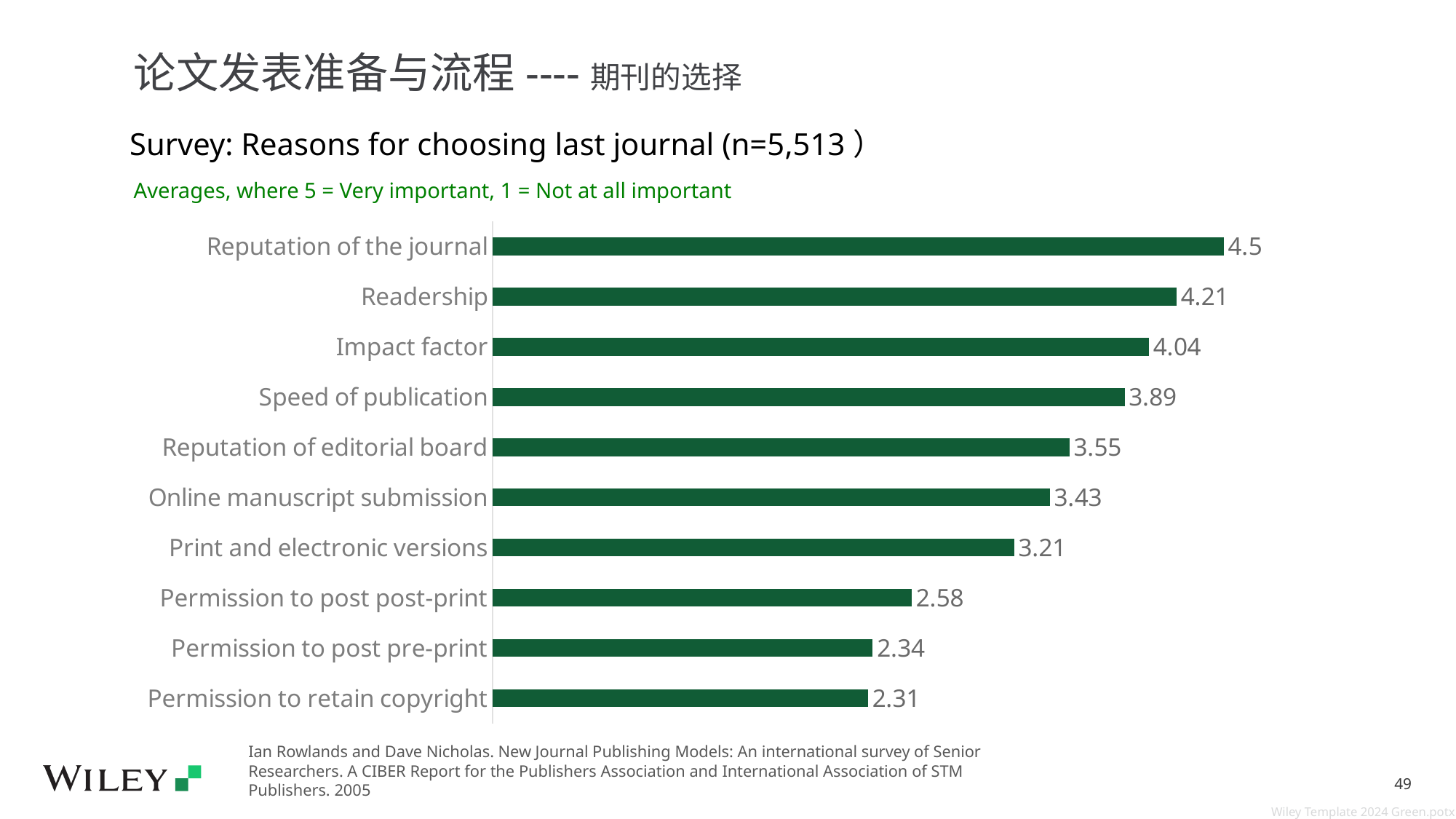
What is the average importance score for Reputation of the journal? 4.5 Which reason has the highest average score? Reputation of the journal What kind of chart is shown on the slide? Bar chart What is the value shown for Speed of publication? 3.89 Which has a higher score, Online manuscript submission or Print and electronic versions? Online manuscript submission How many reasons are listed in the chart? 10 What is the difference between the scores for Readership and Impact factor? 0.17 Which reason has the lowest average score? Permission to retain copyright Which has a higher score, Permission to post post-print or Reputation of editorial board? Reputation of editorial board What is the difference between the scores for Reputation of the journal and Permission to retain copyright? 2.19 What is the value shown for Permission to post pre-print? 2.34 What is the sample size (n) stated in the chart title? 5,513